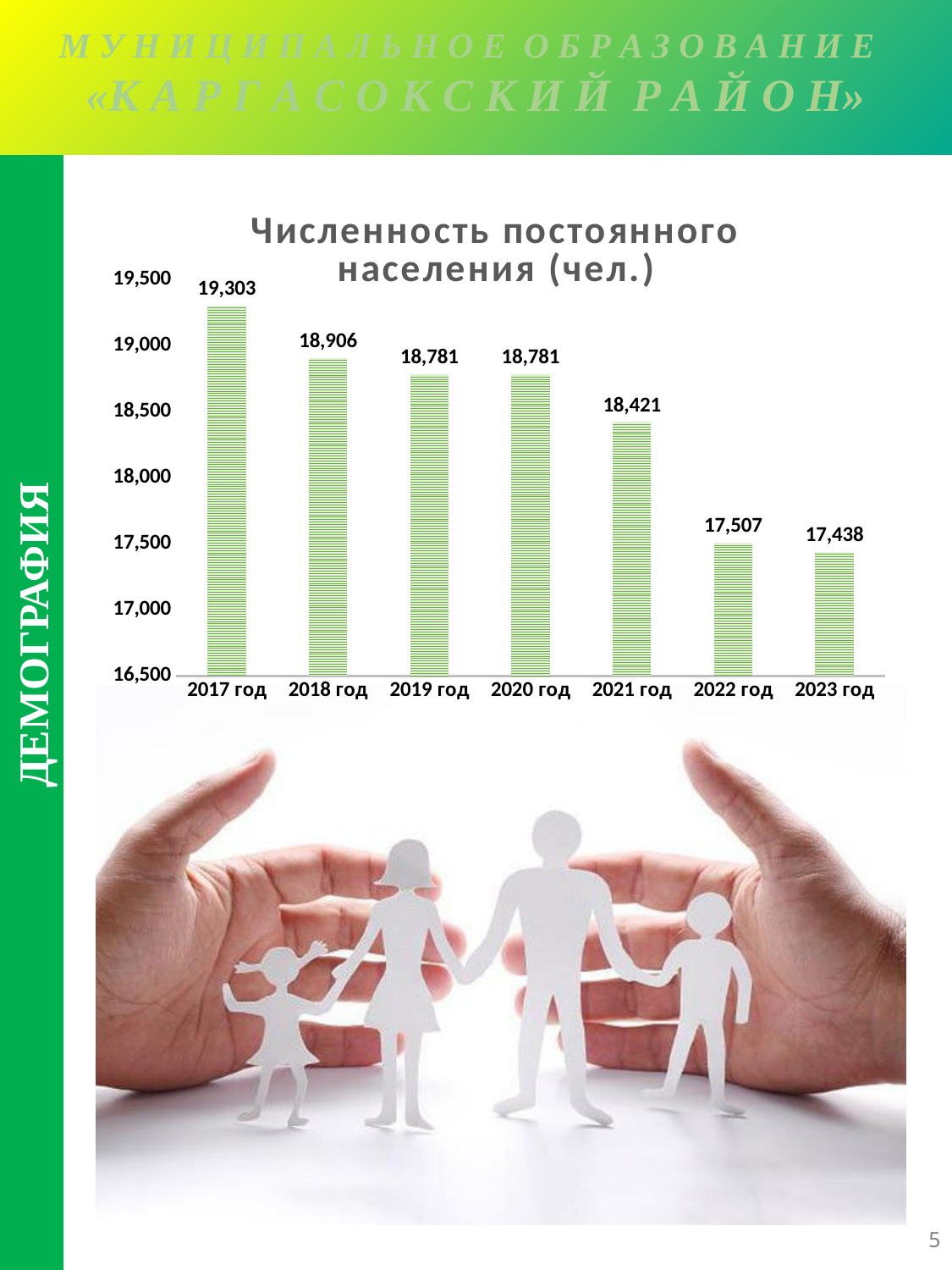
What is the difference between the values for 2021 год and 2022 год? 914 Is the value for 2022 год greater or less than 18,000? less What is the value for 2023 год? 17,438 What is the value for 2021 год? 18,421 Which year has the highest value? 2017 год How many years are shown on the x axis? 7 What is the difference between the values for 2017 год and 2023 год? 1,865 Do the values rise or fall from 2017 год to 2023 год? fall Which year has the lowest value? 2023 год Which is larger, the value for 2018 год or the value for 2022 год? 2018 год What kind of chart is shown on the slide? bar chart What is the value for 2017 год? 19,303